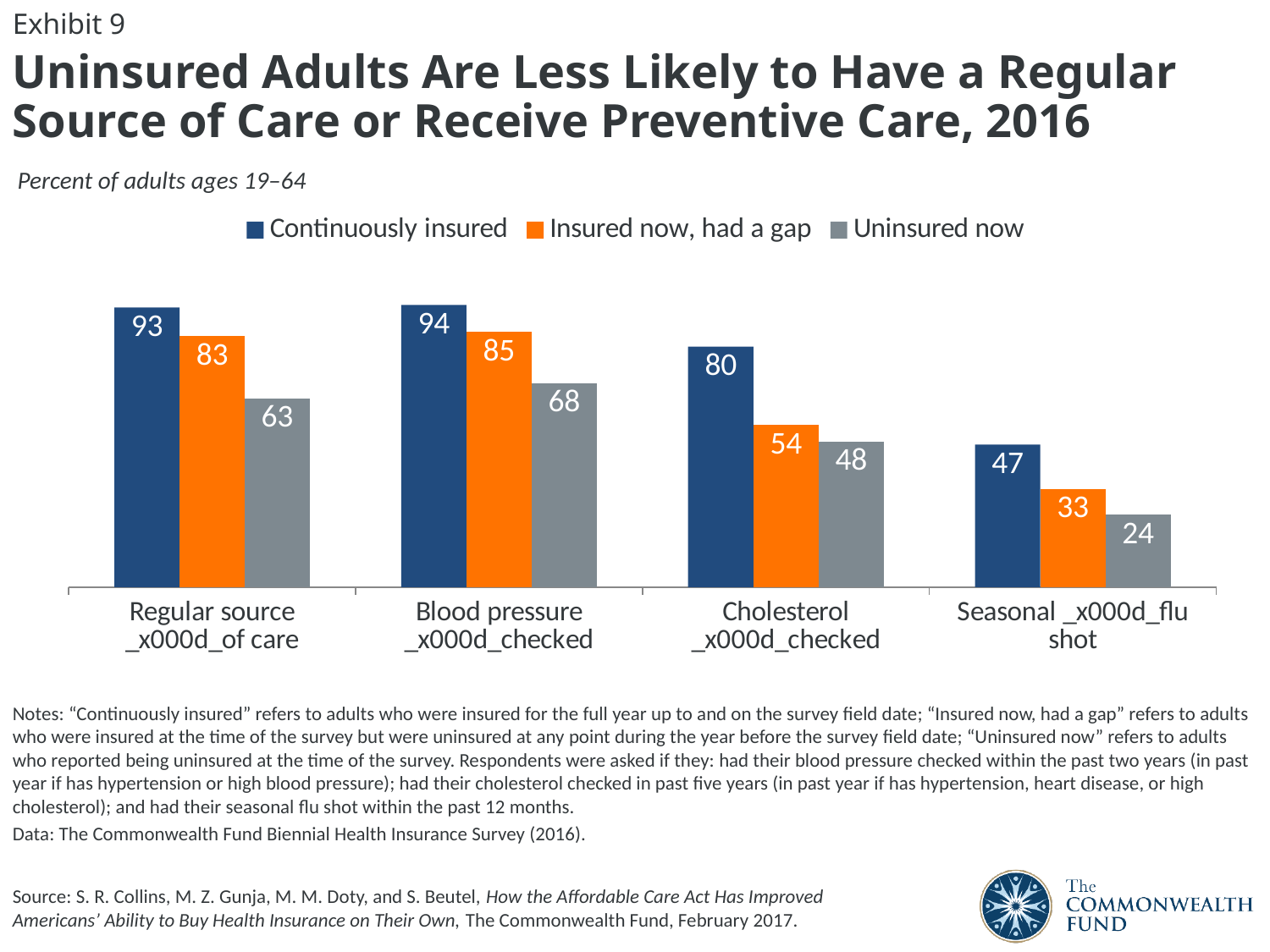
Which category has the lowest value for Uninsured now? Seasonal flu shot What is the value for Uninsured now for Regular source of care? 63 What is the value for Insured now, had a gap for Blood pressure checked? 85 What is the difference between Continuously insured and Uninsured now for Cholesterol checked? 32 Which colour represents the Insured now, had a gap series? Orange What kind of chart is shown? Bar chart Do the Uninsured now values rise or fall from Regular source of care to Seasonal flu shot? Fall How many categories are shown on the x axis? 4 Which category has the highest value for Continuously insured? Blood pressure checked Which is larger for Seasonal flu shot: Insured now, had a gap or Uninsured now? Insured now, had a gap How many series does the legend list? 3 What is the value for Continuously insured for Seasonal flu shot? 47